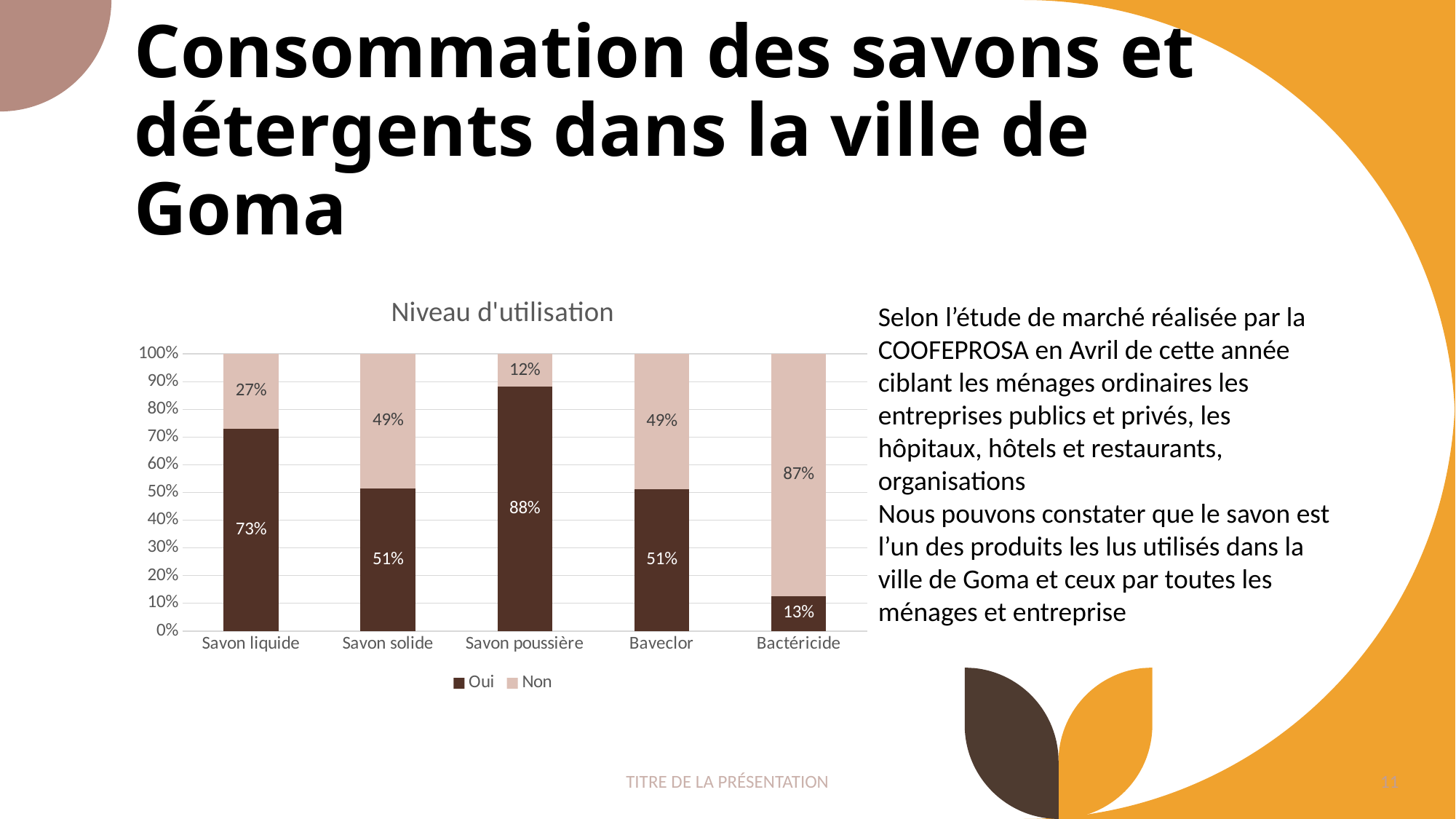
How many categories are shown on the x axis? 5 How many series does the legend list? 2 What kind of chart is shown? Stacked bar chart Which category has the highest 'Oui' value? Savon poussière Which category has the lowest 'Oui' value? Bactéricide Which is larger: the 'Oui' value for Savon liquide or the 'Oui' value for Savon solide? Savon liquide What is the 'Non' value for Savon poussière? 12% What is the 'Non' value for Bactéricide? 87% What is the difference between the 'Oui' values for Savon poussière and Savon liquide? 15% What is the 'Oui' value for Savon liquide? 73% What is the title of the chart? Niveau d'utilisation What is the 'Oui' value for Baveclor? 51%